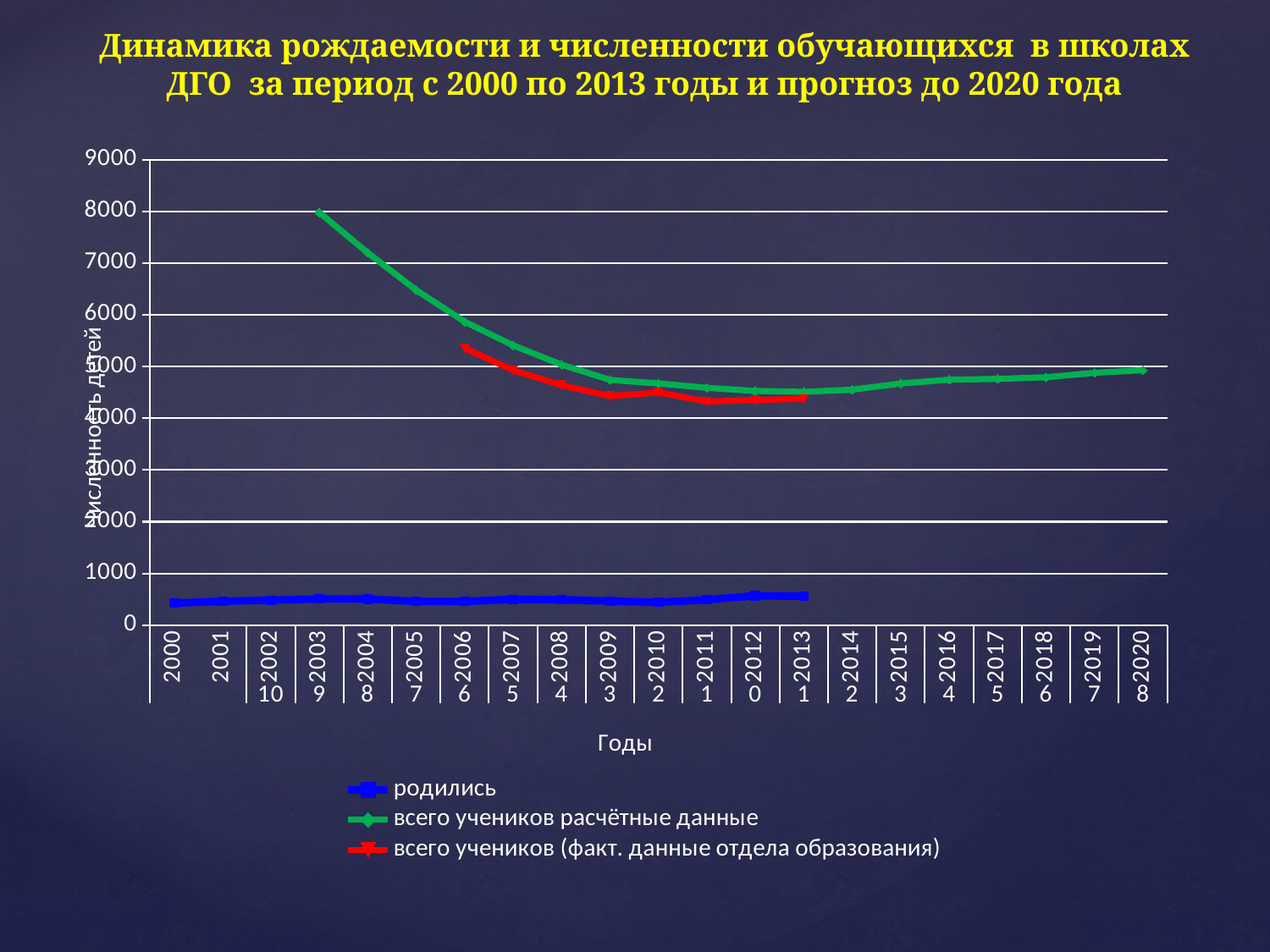
Is the value of the series 'всего учеников расчётные данные' for 2003 greater or less than 7000? greater Does the series 'всего учеников (факт. данные отдела образования)' rise or fall from 2006 to 2011? fall How many series does the legend list? 3 Is the value of the series 'родились' for 2010 greater or less than 1000? less What is the title of the vertical axis? Численность детей Is the value of the series 'всего учеников расчётные данные' for 2013 greater or less than 5000? less In which year does the series 'всего учеников расчётные данные' reach its highest value? 2003 What colour is the line for the series 'родились'? blue For 2007, which series is higher: 'всего учеников расчётные данные' or 'всего учеников (факт. данные отдела образования)'? всего учеников расчётные данные How many years are shown on the x axis? 21 What kind of chart is shown on the slide? line chart